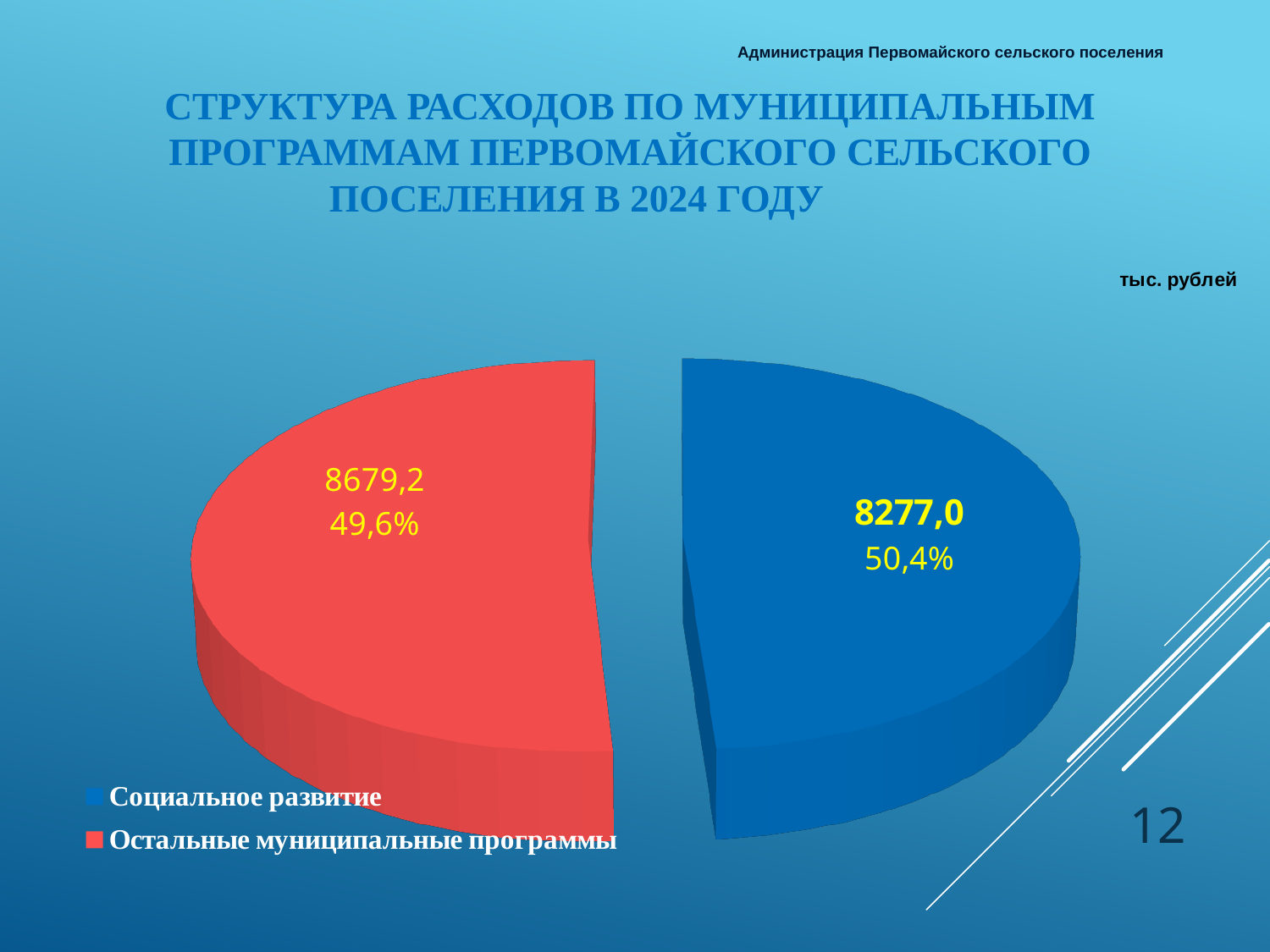
What share of the pie is labelled for Социальное развитие? 50,4% How many slices does the pie chart have? 2 What is the difference between the printed values for Остальные муниципальные программы and Социальное развитие? 402,2 What is the total of the two printed values in the pie chart? 16956,2 Which slice has the larger printed value in тыс. рублей? Остальные муниципальные программы What kind of chart is shown on the slide? Pie chart What is the value (тыс. рублей) for Социальное развитие? 8277,0 What unit is stated for the values in the chart? тыс. рублей Which slice has the larger printed percentage? Социальное развитие What share of the pie is labelled for Остальные муниципальные программы? 49,6% What colour is the slice for Социальное развитие? Blue What is the value (тыс. рублей) for Остальные муниципальные программы? 8679,2